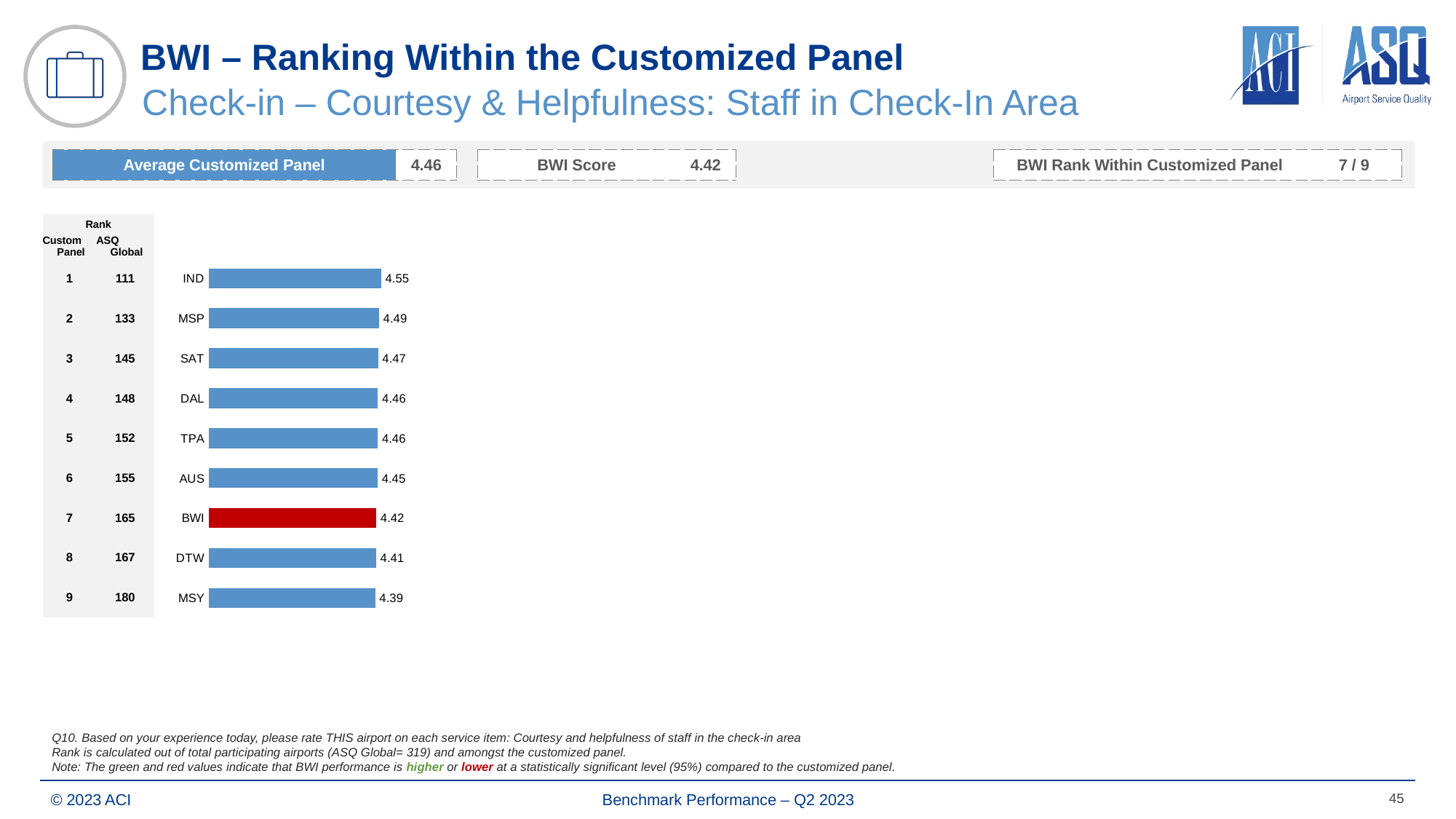
What is the value for BWI? 4.42 What kind of chart is shown on the slide? bar chart What is the value for IND? 4.55 Which airport has the lowest value? MSY What is the difference between the values for MSP and BWI? 0.07 Which bar is coloured red? BWI Which has a larger value, SAT or DTW? SAT What is the value for AUS? 4.45 What is the value for MSY? 4.39 What is the difference between the values for IND and MSY? 0.16 How many airports are shown in the chart? 9 Which airport has the highest value? IND